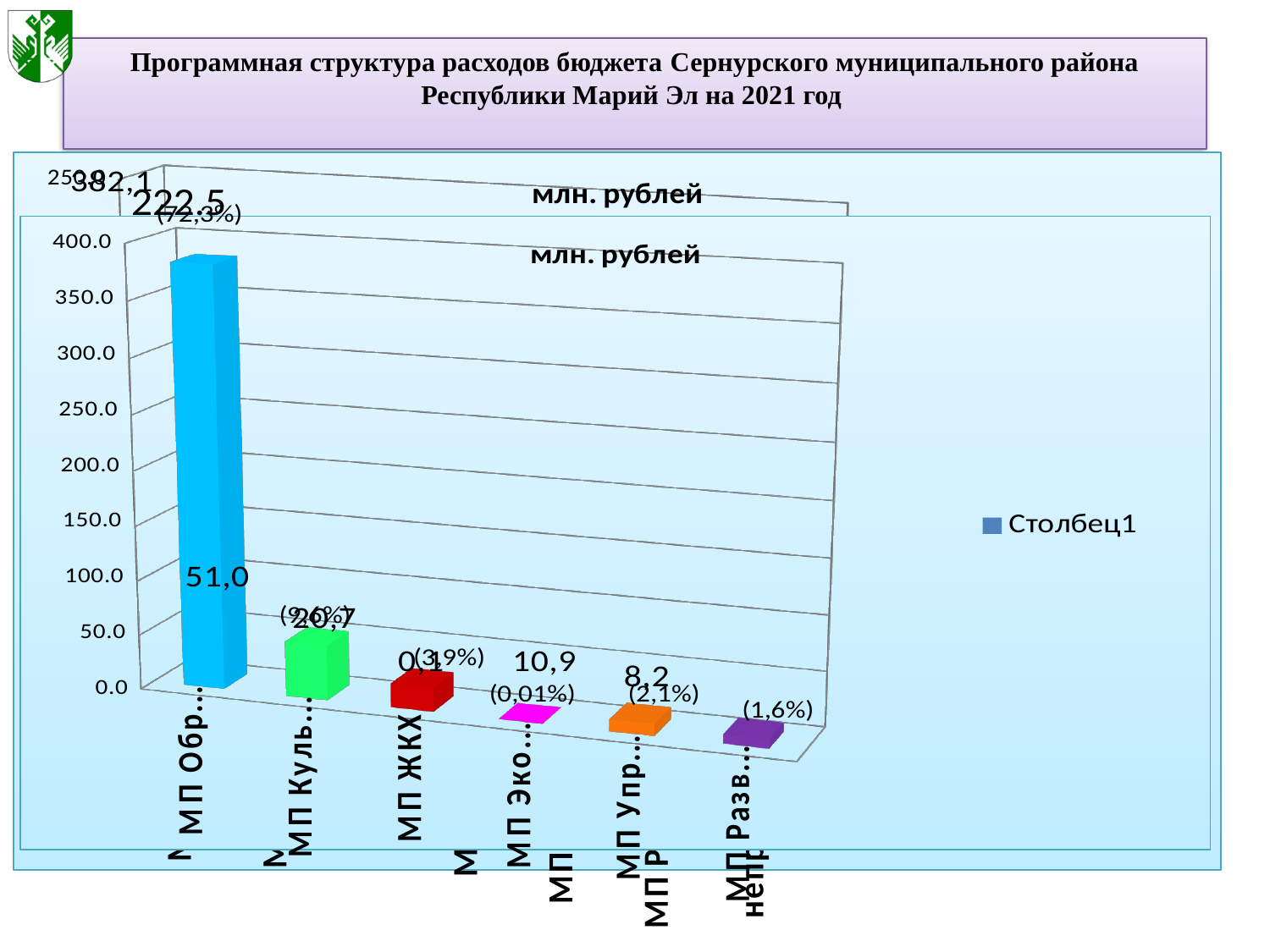
How many series does the legend list? 1 What is the legend entry shown to the right of the chart? Столбец1 Which category has the tallest bar in the chart? МП Обр... Is the value for МП Упр... greater or less than 100? less Do the bar heights generally rise or fall from left to right along the x axis? fall Is the value for МП Обр... greater or less than 300? greater Which bar is taller, МП Куль... or МП ЖКХ? МП Куль... What colour is the bar for МП Обр...? blue What kind of chart is shown on the slide? bar chart Which bar is taller, МП Обр... or МП Куль...? МП Обр... How many bars (categories) are plotted in the chart? 6 Is the value for МП ЖКХ greater or less than 100? less